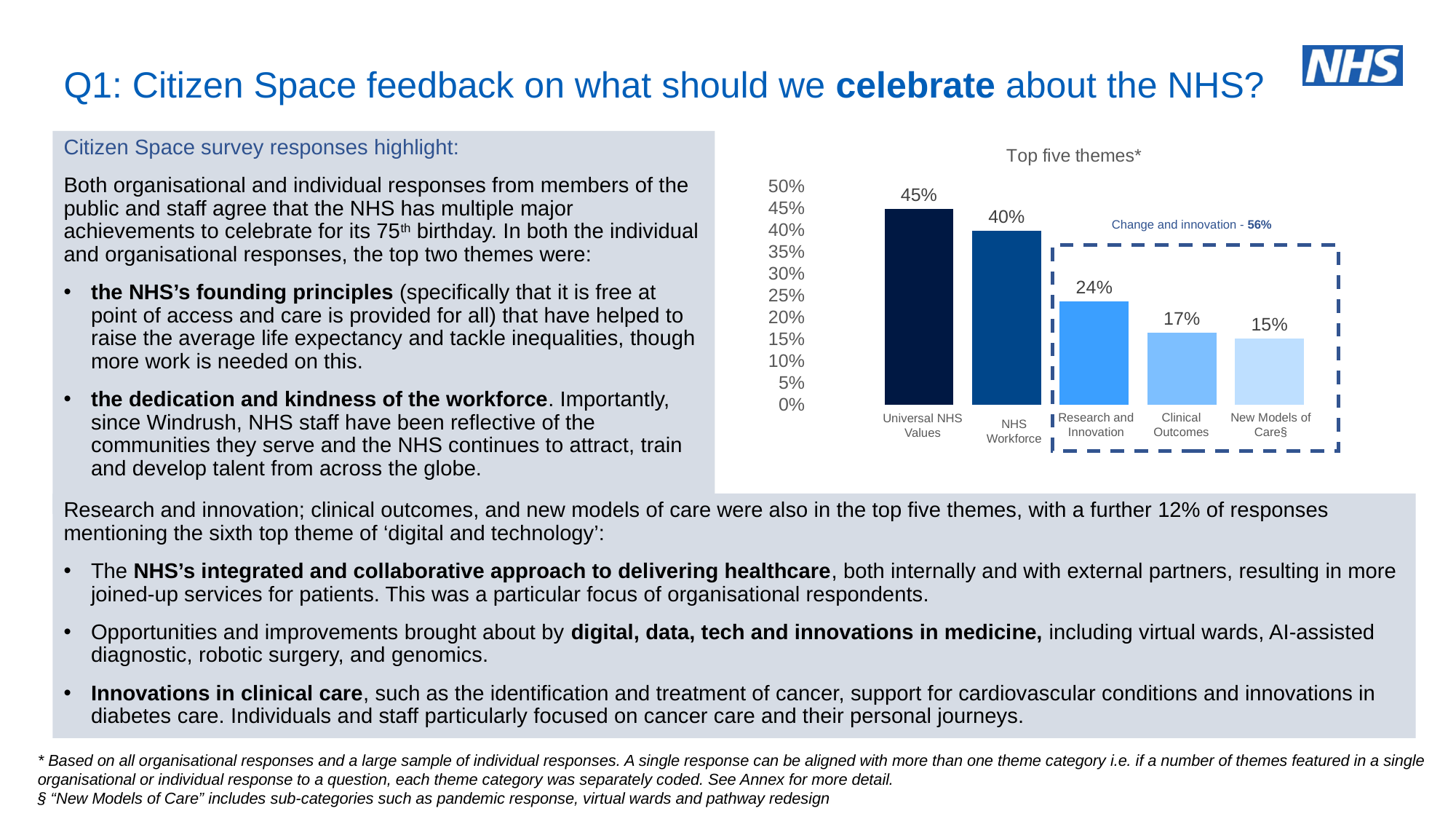
What is the difference between Universal NHS Values and NHS Workforce? 5% What is the value for Universal NHS Values? 45% What is the title of the chart? Top five themes* Which is larger, Clinical Outcomes or New Models of Care? Clinical Outcomes What kind of chart is shown? Bar chart What is the value for Research and Innovation? 24% Which theme has the highest value? Universal NHS Values What is the value for New Models of Care? 15% What is the difference between Research and Innovation and Clinical Outcomes? 7% How many themes are shown in the chart? 5 What is the value for NHS Workforce? 40% Which theme has the lowest value? New Models of Care